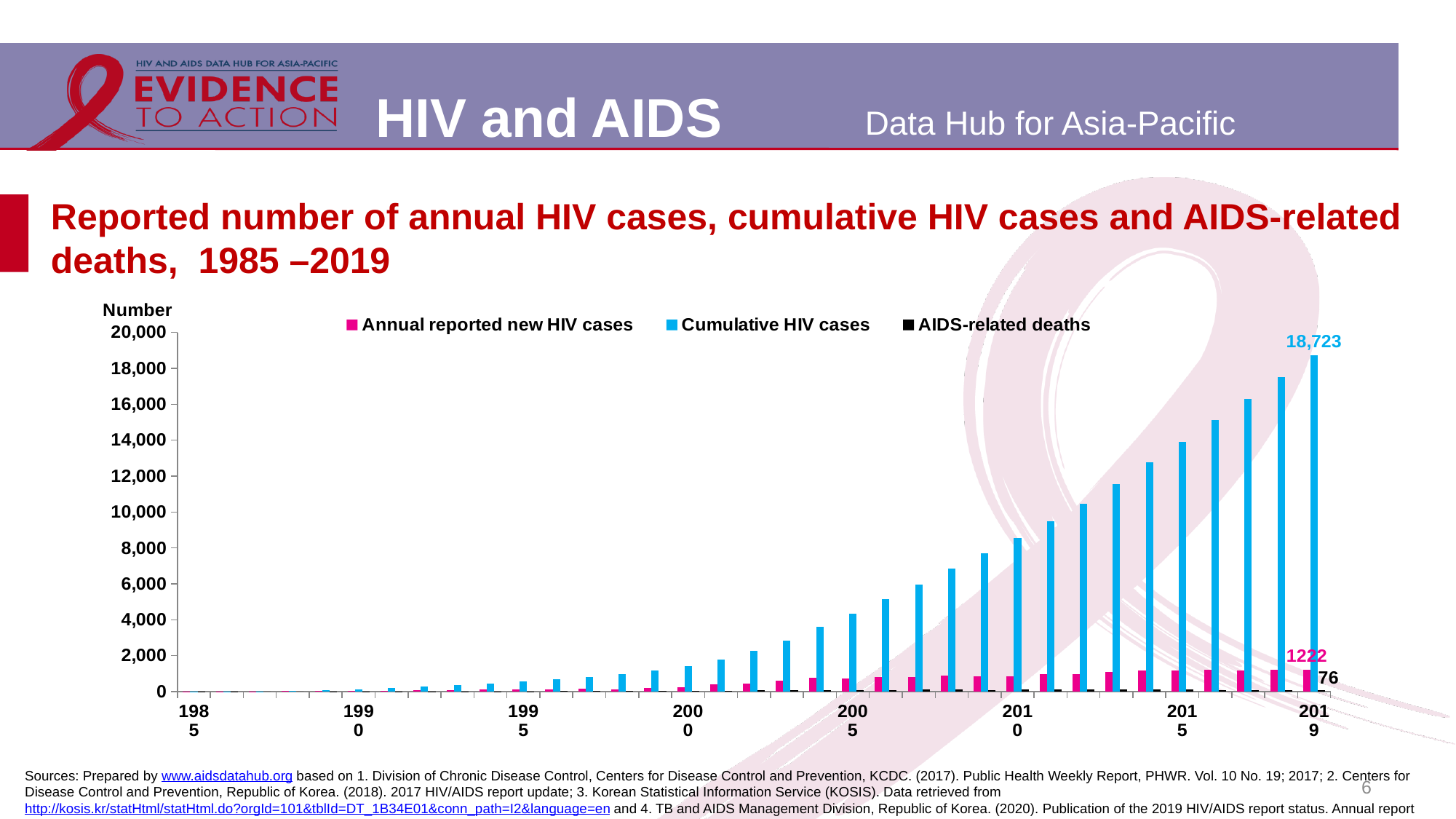
Do cumulative HIV cases rise or fall from 1985 to 2019? Rise How many series does the legend list? 3 What is the difference between annual reported new HIV cases and AIDS-related deaths in 2019? 1146 Which colour represents cumulative HIV cases in the legend? Blue What is the number of AIDS-related deaths shown for 2019? 76 In 2019, which is larger: cumulative HIV cases or AIDS-related deaths? Cumulative HIV cases Is the value of cumulative HIV cases in 2010 greater or less than 6,000? greater How many annual reported new HIV cases are labelled for 2019? 1222 What is the value of cumulative HIV cases in 2019? 18,723 What is the difference between cumulative HIV cases and annual reported new HIV cases in 2019? 17,501 What kind of chart is shown on the slide? Bar chart Is the value of cumulative HIV cases in 2000 greater or less than 2,000? less